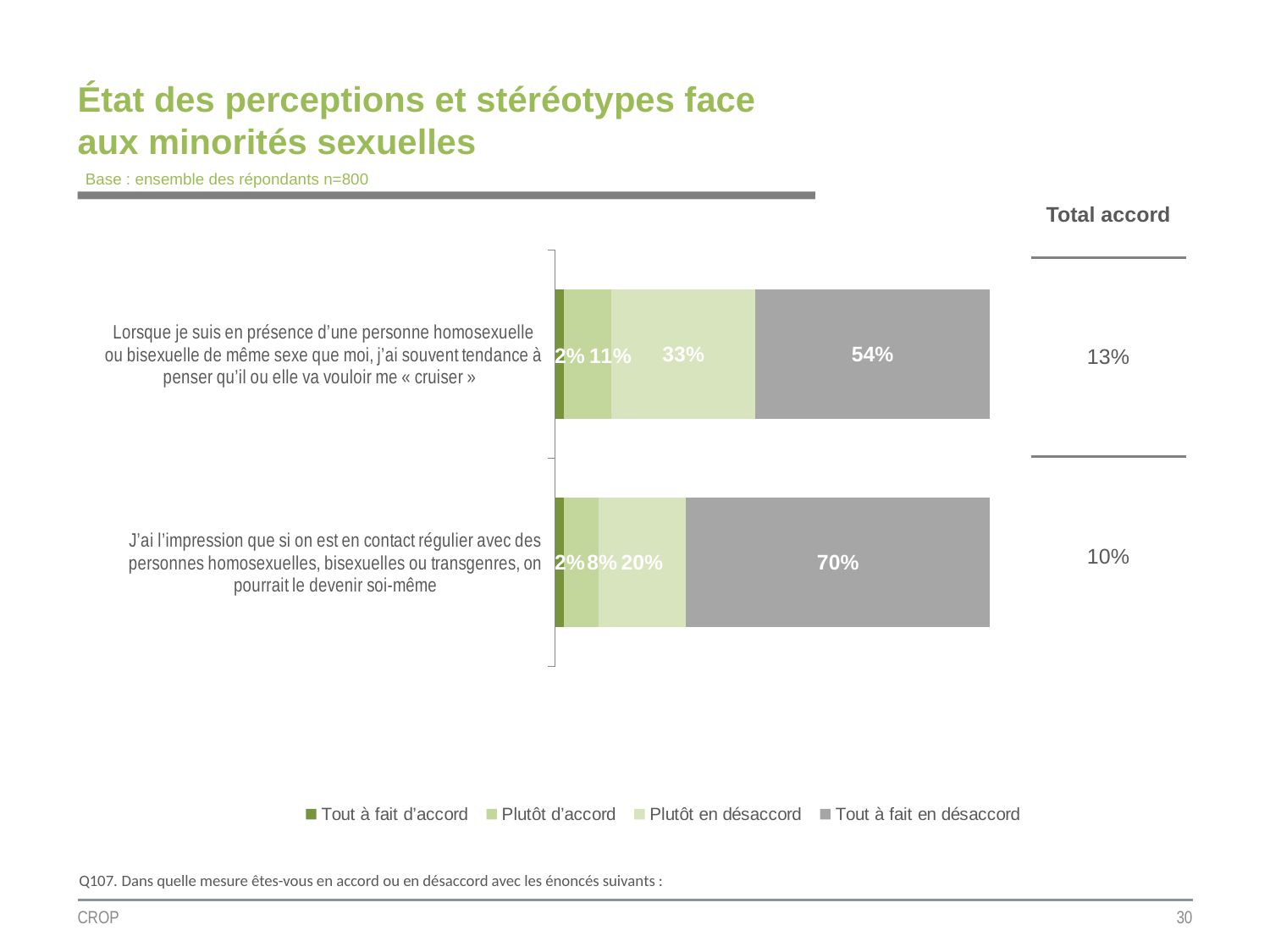
What is the 'Total accord' shown for the top statement? 13% Which statement has the higher 'Tout à fait en désaccord' value? The bottom statement (about becoming homosexual, bisexual or transgender through regular contact) What is the 'Tout à fait en désaccord' value for the bottom statement? 70% What is the 'Plutôt d'accord' value for the bottom statement (about becoming homosexual, bisexual or transgender through regular contact)? 8% What is the 'Plutôt en désaccord' value for the top statement? 33% Which legend entry is represented by the dark grey segments? Tout à fait en désaccord How many statements (categories) are plotted in the chart? 2 Is the 'Plutôt en désaccord' value for the top statement larger or smaller than that for the bottom statement? Larger What is the difference between the 'Tout à fait en désaccord' values of the bottom and top statements? 16 percentage points How many series does the legend list? 4 What kind of chart is shown on the slide? Stacked bar chart What is the 'Tout à fait en désaccord' value for the top statement (about thinking a homosexual or bisexual person of the same sex will want to 'cruiser' them)? 54%